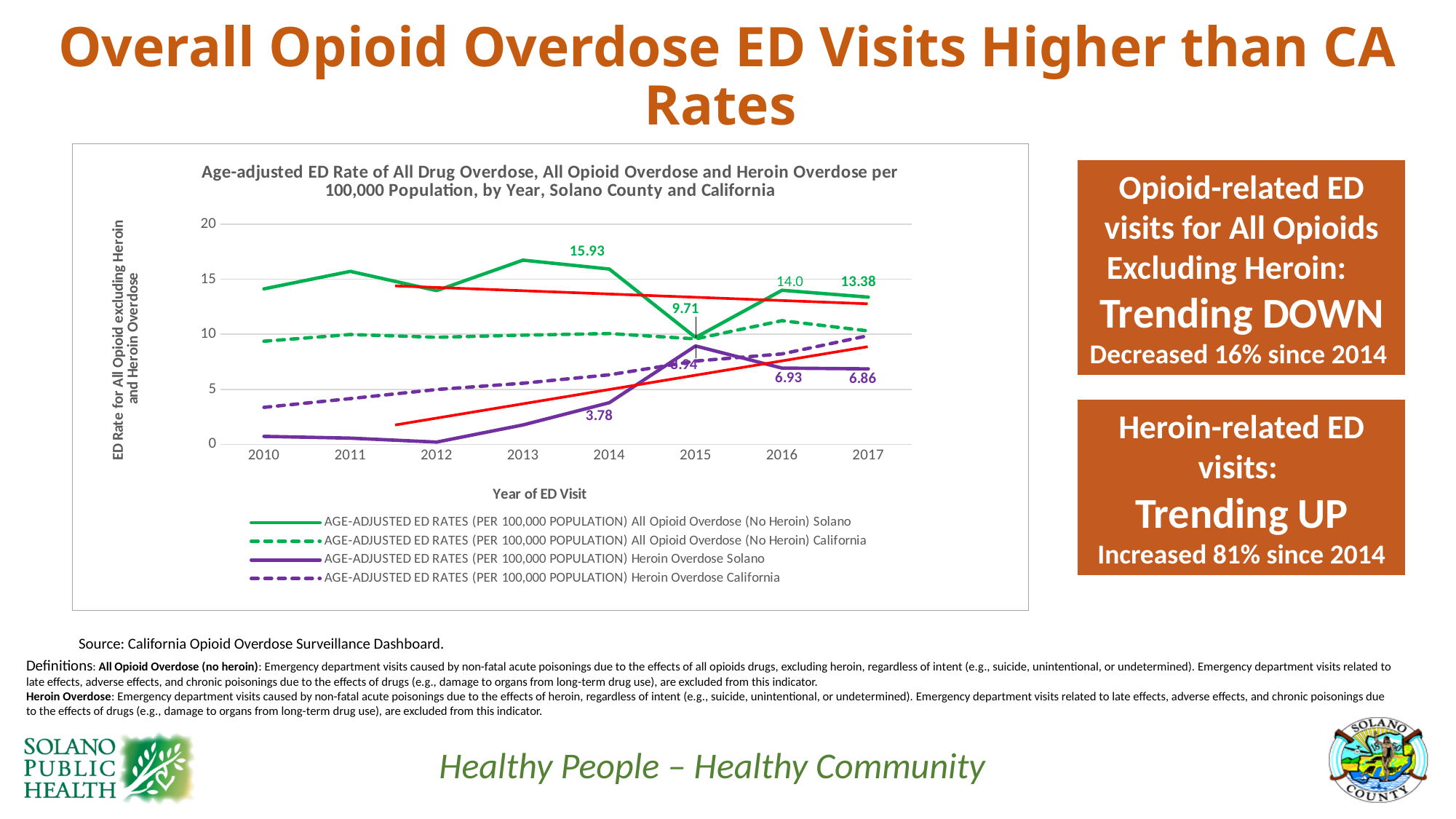
Is the Heroin Overdose California rate in 2010 greater or less than 5? less What is the All Opioid Overdose (No Heroin) Solano rate in 2014? 15.93 How many series does the chart's legend list? 4 What is the Heroin Overdose Solano rate in 2014? 3.78 By how much did the All Opioid Overdose (No Heroin) Solano rate fall from 2014 to 2015? 6.22 What is the difference between the Heroin Overdose Solano rates in 2016 and 2017? 0.07 In which year is the Heroin Overdose Solano rate lowest? 2012 What kind of chart is shown on the slide? Line chart What is the All Opioid Overdose (No Heroin) Solano rate in 2017? 13.38 How many years are plotted along the x axis of the chart? 8 What is the Heroin Overdose Solano rate in 2017? 6.86 For the All Opioid Overdose (No Heroin) Solano series, which year has the larger value, 2015 or 2016? 2016